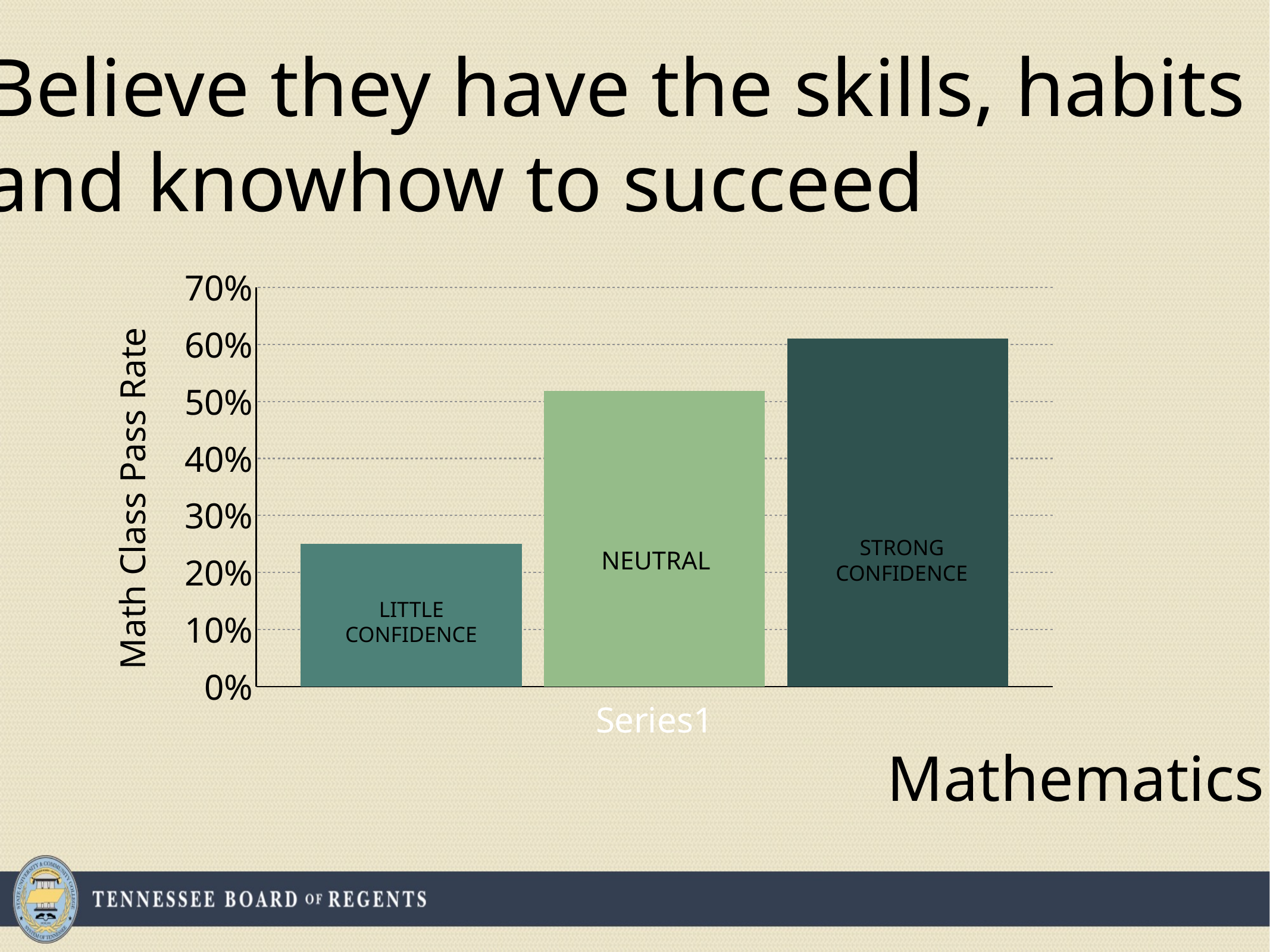
Which category has the highest math class pass rate? STRONG CONFIDENCE What is the title of the vertical axis? Math Class Pass Rate What kind of chart is shown on the slide? bar chart Is the value for STRONG CONFIDENCE greater or less than 70%? less How many bars are plotted in the chart? 3 Which has a higher pass rate, STRONG CONFIDENCE or NEUTRAL? STRONG CONFIDENCE Is the value for NEUTRAL greater or less than 50%? greater Is the value for LITTLE CONFIDENCE greater or less than 30%? less Do the bar values rise or fall from LITTLE CONFIDENCE to STRONG CONFIDENCE? rise Which category has the lowest math class pass rate? LITTLE CONFIDENCE Which has a higher pass rate, NEUTRAL or LITTLE CONFIDENCE? NEUTRAL